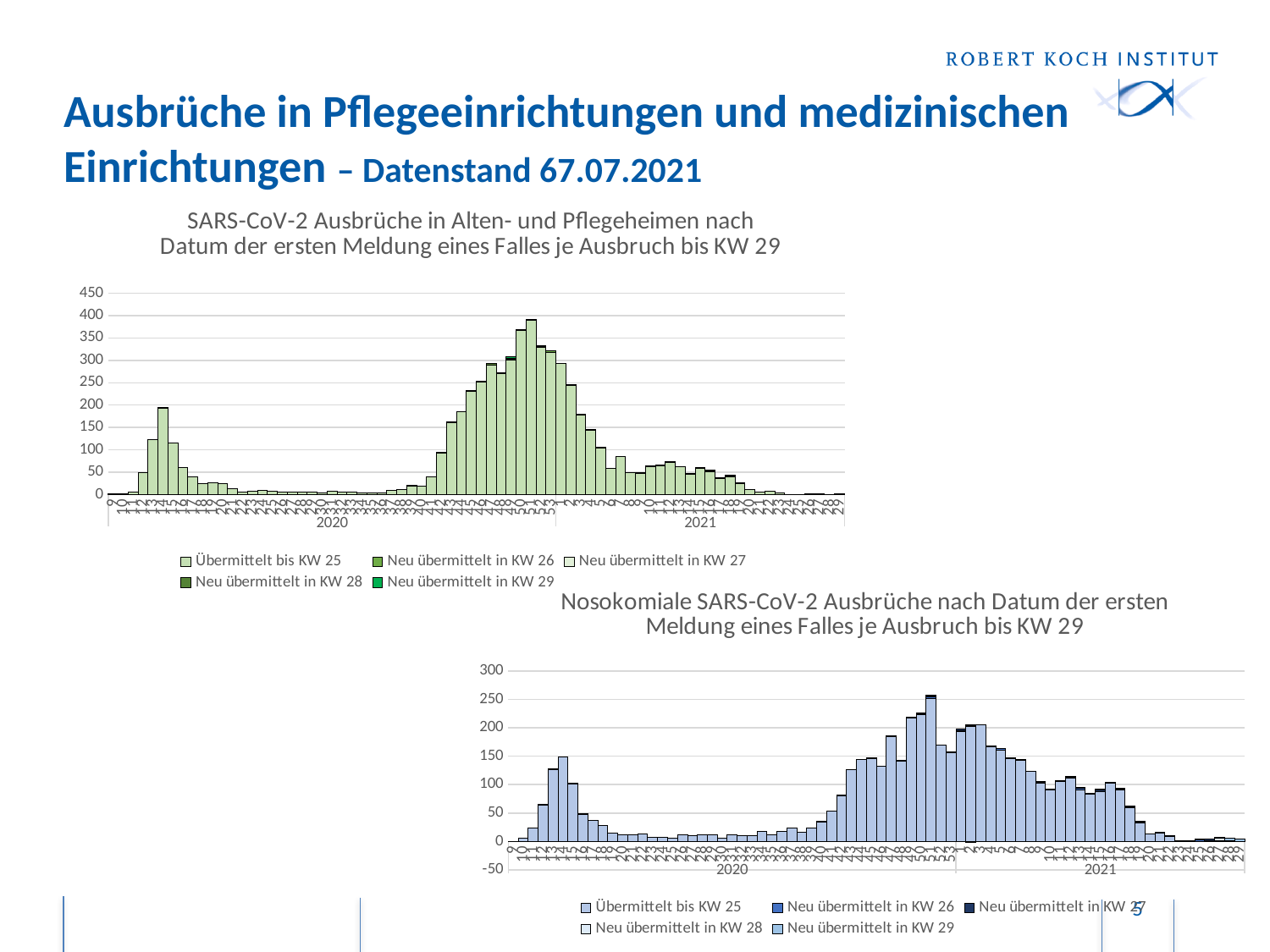
In the top chart, is the value of the highest bar greater or less than 450? less How many series does the legend of the bottom chart list? 5 In the top chart, do the values rise or fall from the peak in late 2020 to the last weeks shown in 2021? fall How many series does the legend of the top chart list? 5 In the bottom chart, is the value of the highest bar greater or less than 200? greater What is the first legend entry of the top chart? Übermittelt bis KW 25 In the bottom chart, do the values rise or fall from the peak in late 2020 to the last weeks shown in 2021? fall What is the highest value shown on the y-axis of the top chart? 450 In the bottom chart, is the value of the highest bar greater or less than 300? less What kind of chart is the bottom chart, 'Nosokomiale SARS-CoV-2 Ausbrüche'? Bar chart What kind of chart is the top chart, 'SARS-CoV-2 Ausbrüche in Alten- und Pflegeheimen'? Bar chart